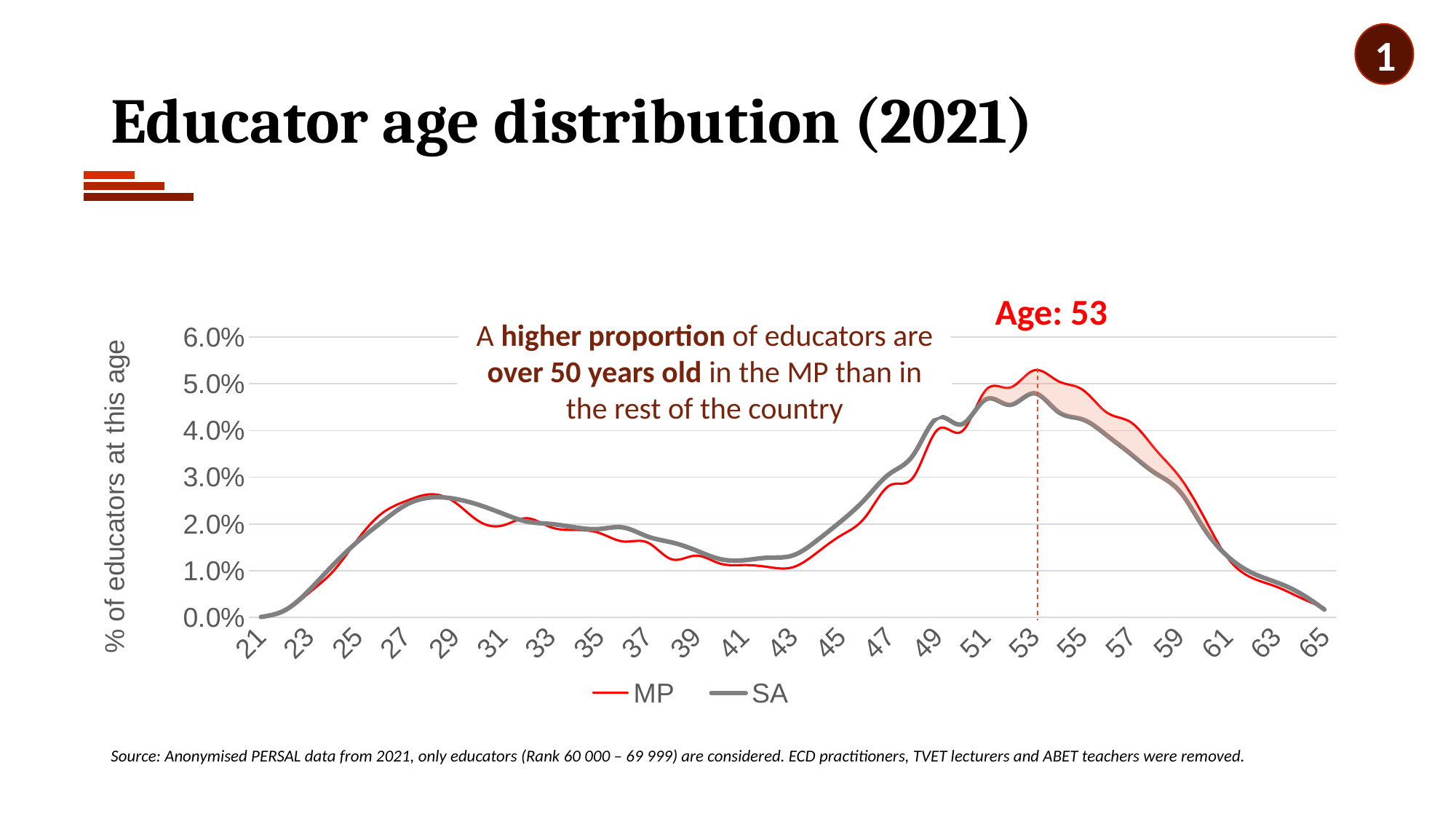
Is the value for MP at age 53 greater or less than 5.0%? greater Is the value for SA at age 53 greater or less than 5.0%? less At which age does the MP series reach its highest value, as marked on the chart? 53 How many series does the legend list? 2 What are the two series named in the legend? MP and SA What is the label on the vertical axis of the chart? % of educators at this age Do the values for both series rise or fall between age 53 and age 65? Fall What kind of chart is shown on the slide? Line chart Is the value for SA at age 29 greater or less than 2.0%? greater At age 57, which series has the higher value, MP or SA? MP At age 47, which series has the higher value, MP or SA? SA